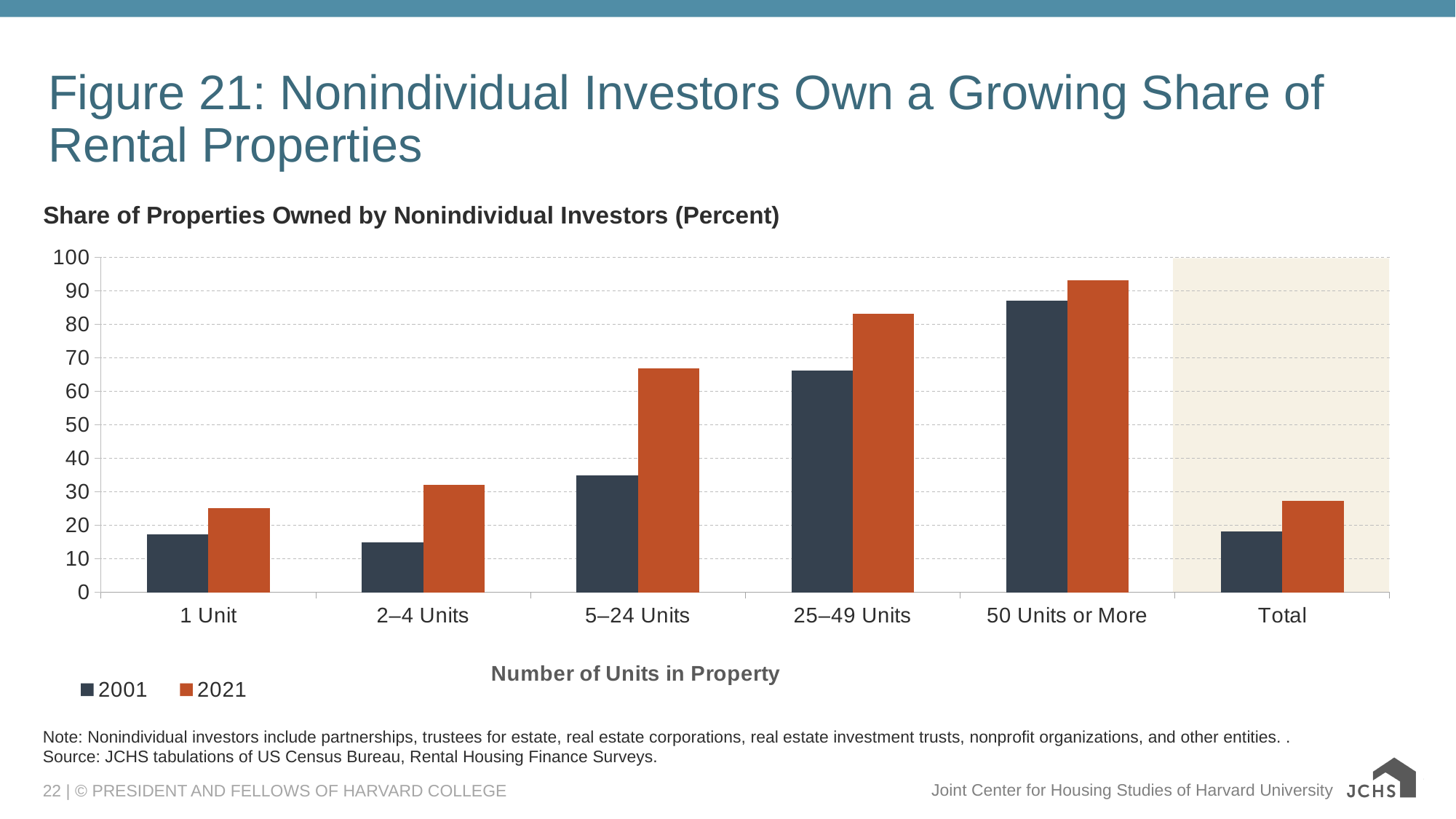
How many categories are shown on the x axis? 6 Which category has the highest value for 2021? 50 Units or More Is the 2021 value for Total greater or less than 30? less How many series does the legend list? 2 For 2021, which is larger: the value for 1 Unit or the value for 2–4 Units? 2–4 Units What kind of chart is shown on the slide? Bar chart Is the 2001 value for 50 Units or More greater or less than 80? greater Do the 2021 values rise or fall moving from 1 Unit to 50 Units or More? rise Is the 2021 value for 5–24 Units greater or less than 60? greater Which category has the highest value for 2001? 50 Units or More For 2–4 Units, which is larger: the 2001 value or the 2021 value? 2021